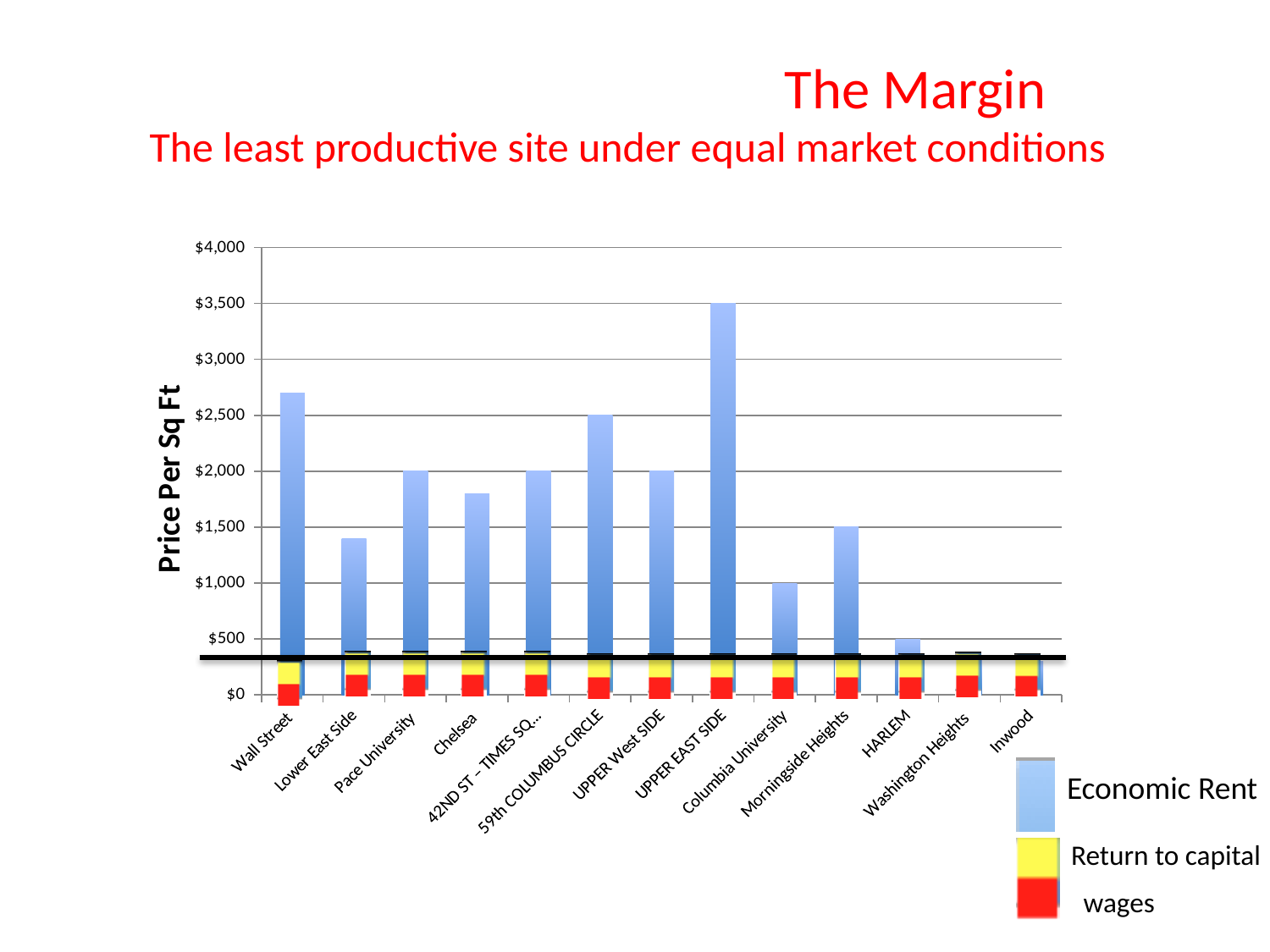
Is the value for Wall Street greater or less than $2,500? greater What is the value for Columbia University? $1,000 Which is larger, the value for Wall Street or the value for Lower East Side? Wall Street What is the value for 59th COLUMBUS CIRCLE? $2,500 What is the difference between the values for UPPER EAST SIDE and Columbia University? $2,500 How many series does the legend list? 3 What is the value for UPPER EAST SIDE? $3,500 Which site has the highest bar in the chart? UPPER EAST SIDE What is the value for Morningside Heights? $1,500 What type of chart is shown on the slide? bar chart How many sites are shown on the x axis of the chart? 13 Is the value for Lower East Side greater or less than $1,500? less